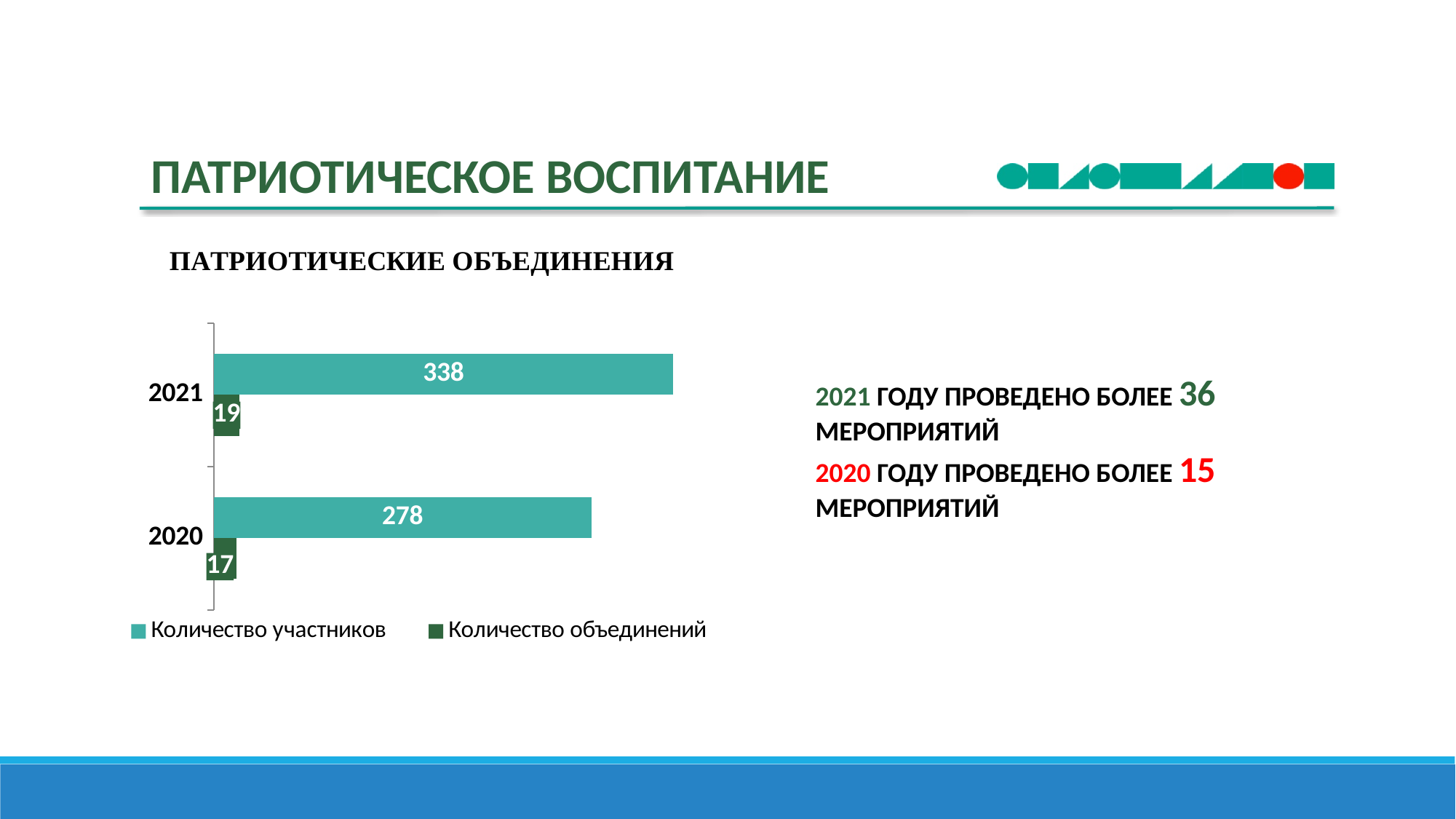
What is the value of Количество объединений for 2020? 17 What kind of chart is shown on the slide? Bar chart Which year has the higher value for Количество участников? 2021 What is the value of Количество объединений for 2021? 19 What is the value of Количество участников for 2021? 338 Which year has the lower value for Количество объединений? 2020 Is Количество участников larger in 2020 or in 2021? 2021 What is the value of Количество участников for 2020? 278 What is the difference between Количество объединений in 2021 and 2020? 2 What is the difference between Количество участников in 2021 and 2020? 60 How many series does the legend list? 2 How many years are shown on the chart? 2